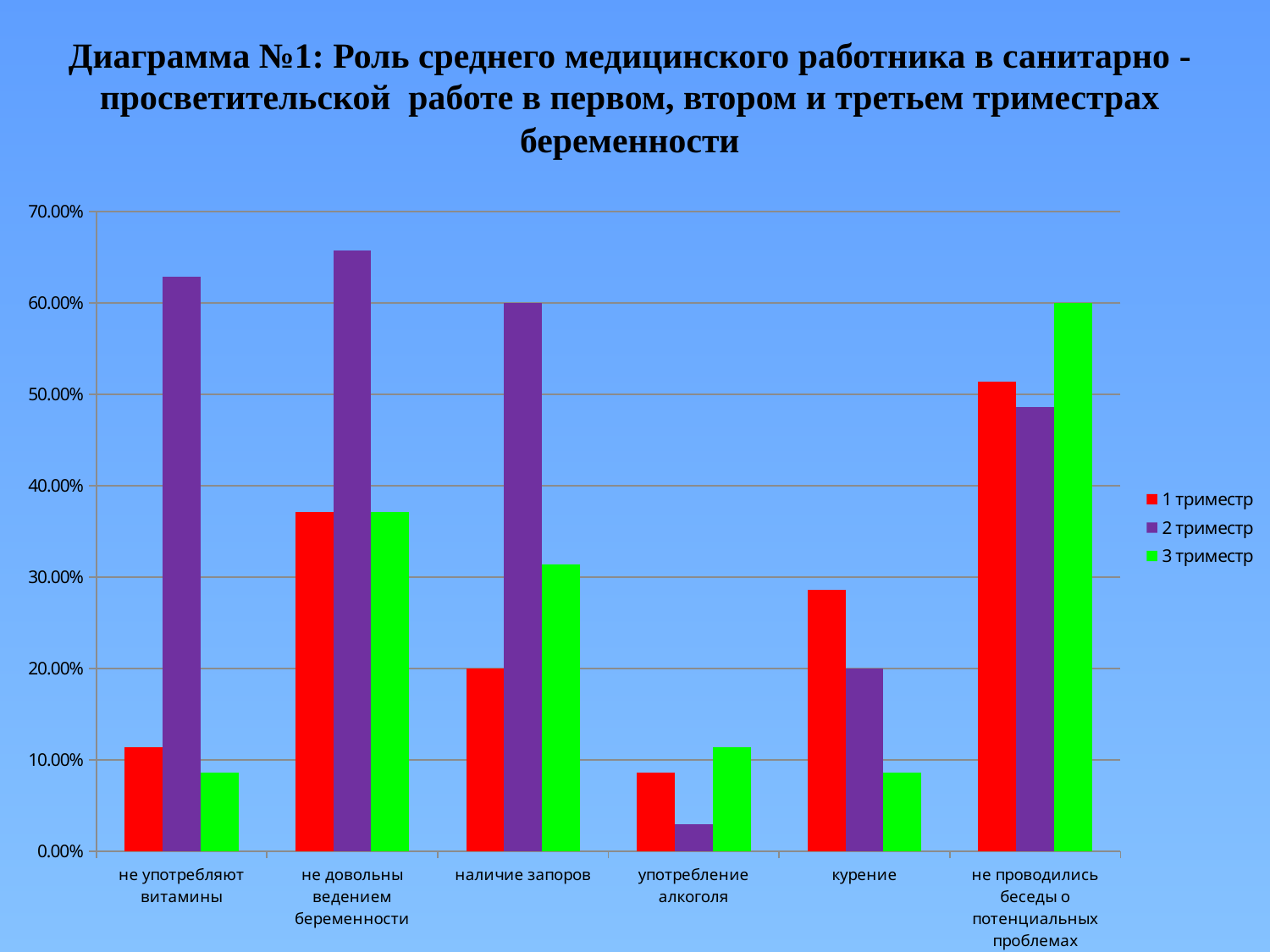
Which category has the highest value for the 2 триместр series? не довольны ведением беременности Is the value for 3 триместр in the category 'курение' greater or less than 10.00%? less In the category 'не употребляют витамины', which is larger: the value for 2 триместр or for 3 триместр? 2 триместр What kind of chart is shown on the slide? bar chart What are the three series listed in the legend? 1 триместр, 2 триместр, 3 триместр In the category 'курение', which is larger: the value for 1 триместр or for 2 триместр? 1 триместр Which category has the highest value for the 1 триместр series? не проводились беседы о потенциальных проблемах Which category has the lowest value for the 2 триместр series? употребление алкоголя How many series does the legend list? 3 Which category has the highest value for the 3 триместр series? не проводились беседы о потенциальных проблемах How many categories are shown along the x axis? 6 Is the value for 2 триместр in the category 'не употребляют витамины' greater or less than 60.00%? greater